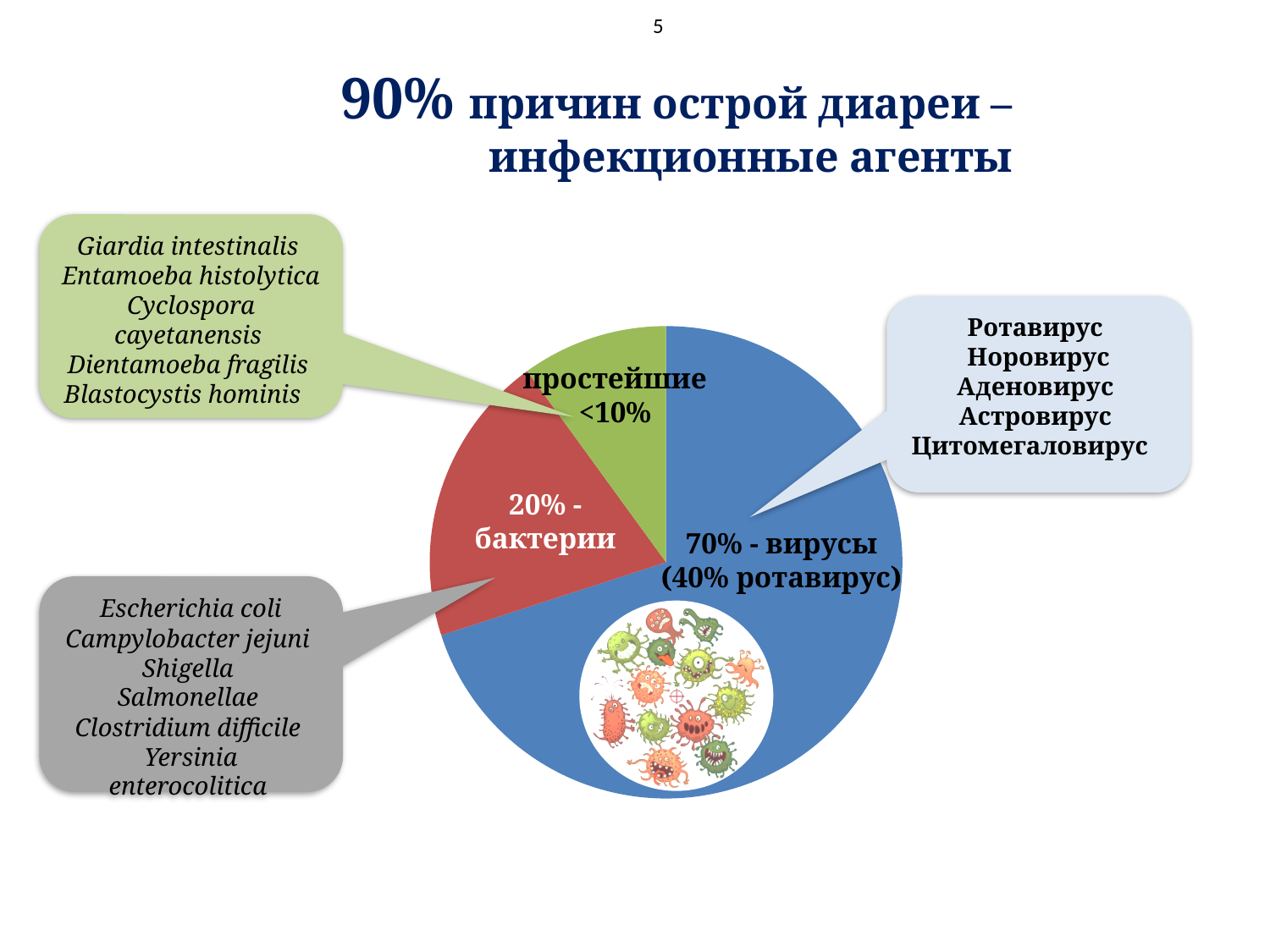
By how many percentage points does the вирусы slice exceed the бактерии slice? 50 What share of the pie is labelled for бактерии (bacteria)? 20% What colour is the бактерии slice of the pie chart? red What kind of chart is shown on the slide? pie chart Which is larger, the бактерии slice or the простейшие slice? бактерии What colour is the вирусы slice of the pie chart? blue How many slices does the pie chart have? 3 Which slice of the pie chart is the largest? вирусы What share is printed on the простейшие (protozoa) slice? <10% Which slice of the pie chart is the smallest? простейшие What share of the pie is labelled for вирусы (viruses)? 70% What percentage is given for ротавирус within the вирусы slice? 40%